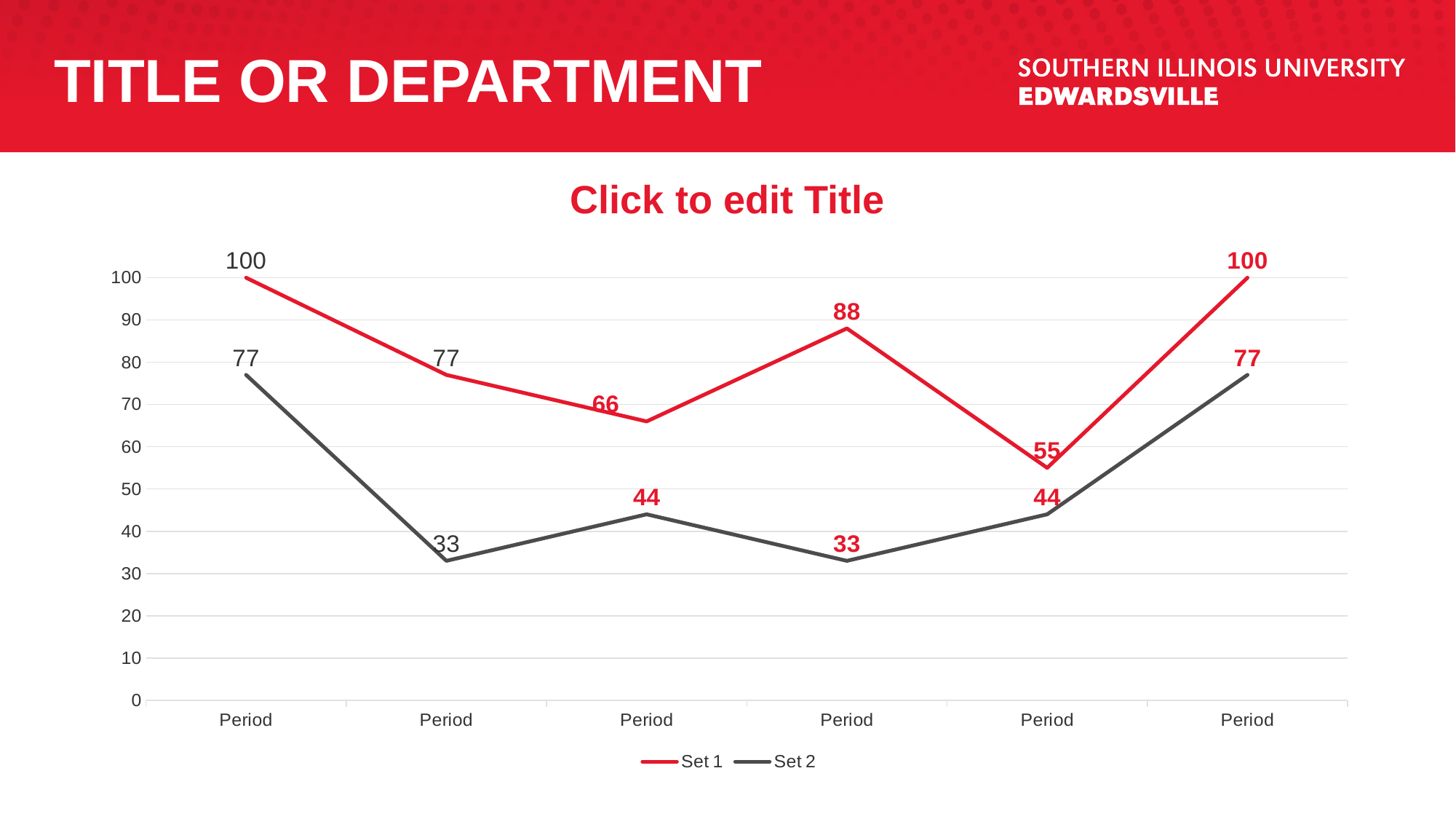
What is the value of Set 2 at the third period? 44 What is the lowest value of Set 1? 55 At the second period, which series has the larger value, Set 1 or Set 2? Set 1 What is the difference between Set 1's value at the first period and its value at the fifth period? 45 What colour is the line for Set 1? Red Does Set 2 rise or fall from the first period to the second period? Fall What kind of chart is shown on the slide? Line chart At the fourth period, what is the difference between Set 1 and Set 2? 55 What is the value of Set 1 at the fourth period? 88 What is the highest value of Set 2? 77 How many periods are plotted along the x axis? 6 How many series does the legend list? 2